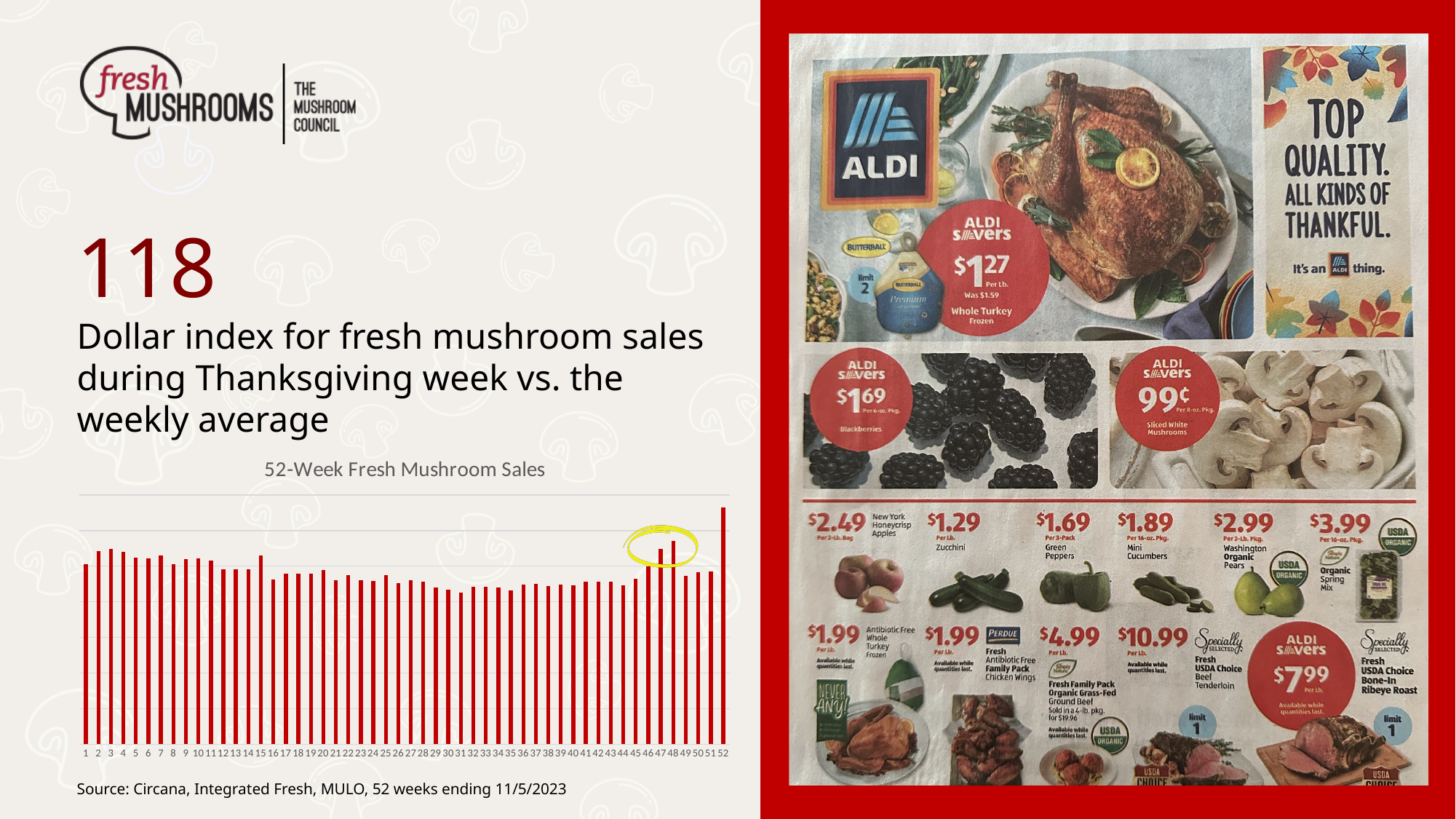
Is the bar for week 52 taller or shorter than the bar for week 1? taller Do the bars generally rise or fall from week 1 to week 31? fall Is the bar for week 48 taller or shorter than the bar for week 47? taller What kind of chart is shown on the slide? bar chart Is the bar for week 47 taller or shorter than the bar for week 46? taller Which week has the highest bar in the 52-Week Fresh Mushroom Sales chart? 52 What is the title of the chart on the slide? 52-Week Fresh Mushroom Sales Do the bars generally rise or fall from week 44 to week 52? rise How many weeks (bars) are plotted in the 52-Week Fresh Mushroom Sales chart? 52